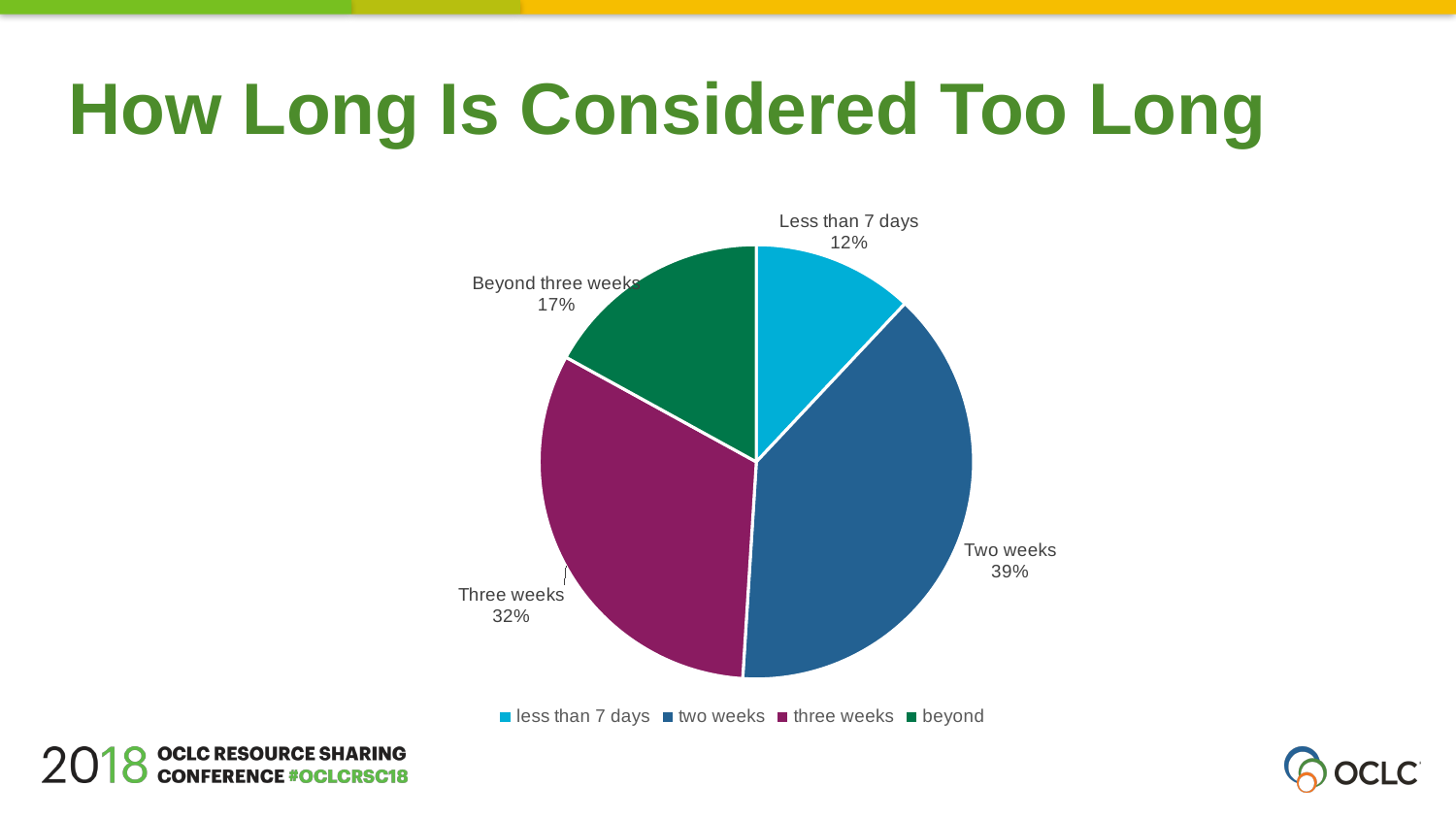
What share of the pie is 'Less than 7 days'? 12% What share of the pie is 'Two weeks'? 39% What share of the pie is 'Beyond three weeks'? 17% What is the difference in percentage points between 'Beyond three weeks' and 'Less than 7 days'? 5 Which category has the largest slice of the pie? Two weeks How many slices does the pie chart have? 4 Which is larger, the slice for 'Three weeks' or the slice for 'Beyond three weeks'? Three weeks What kind of chart is shown on the slide? pie chart What is the difference in percentage points between 'Two weeks' and 'Three weeks'? 7 What is the title of the slide containing the pie chart? How Long Is Considered Too Long Which category has the smallest slice of the pie? Less than 7 days